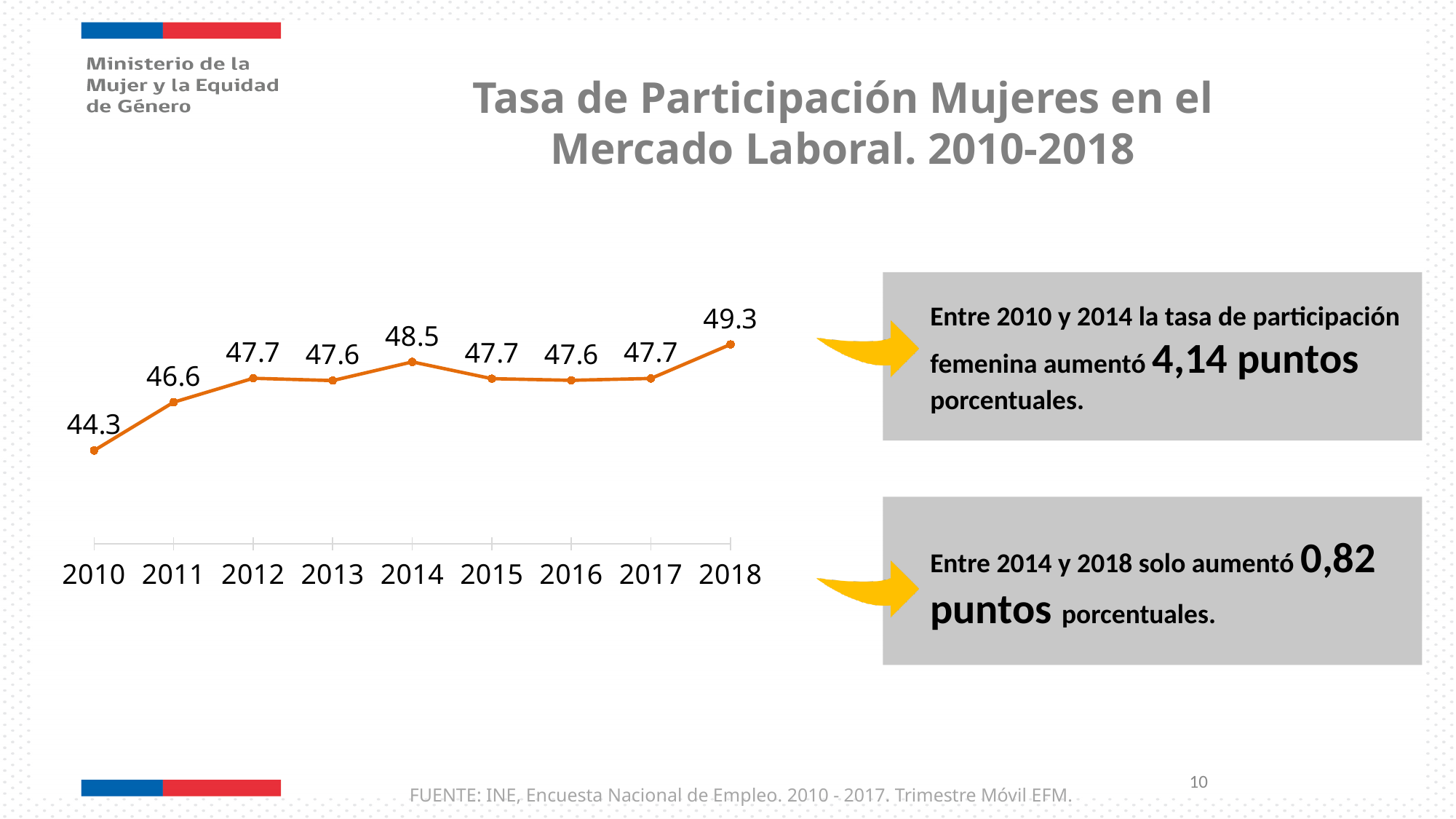
Which year has the highest value? 2018 What is the value for 2018? 49.3 What is the difference between the values for 2014 and 2013? 0.9 What is the value for 2014? 48.5 What is the value for 2011? 46.6 How many years are plotted on the chart? 9 Which is larger, the value for 2014 or the value for 2015? 2014 What kind of chart is shown? Line chart What is the title of the chart? Tasa de Participación Mujeres en el Mercado Laboral. 2010-2018 What is the difference between the values for 2018 and 2010? 5.0 Which year has the lowest value? 2010 What is the value for 2010? 44.3